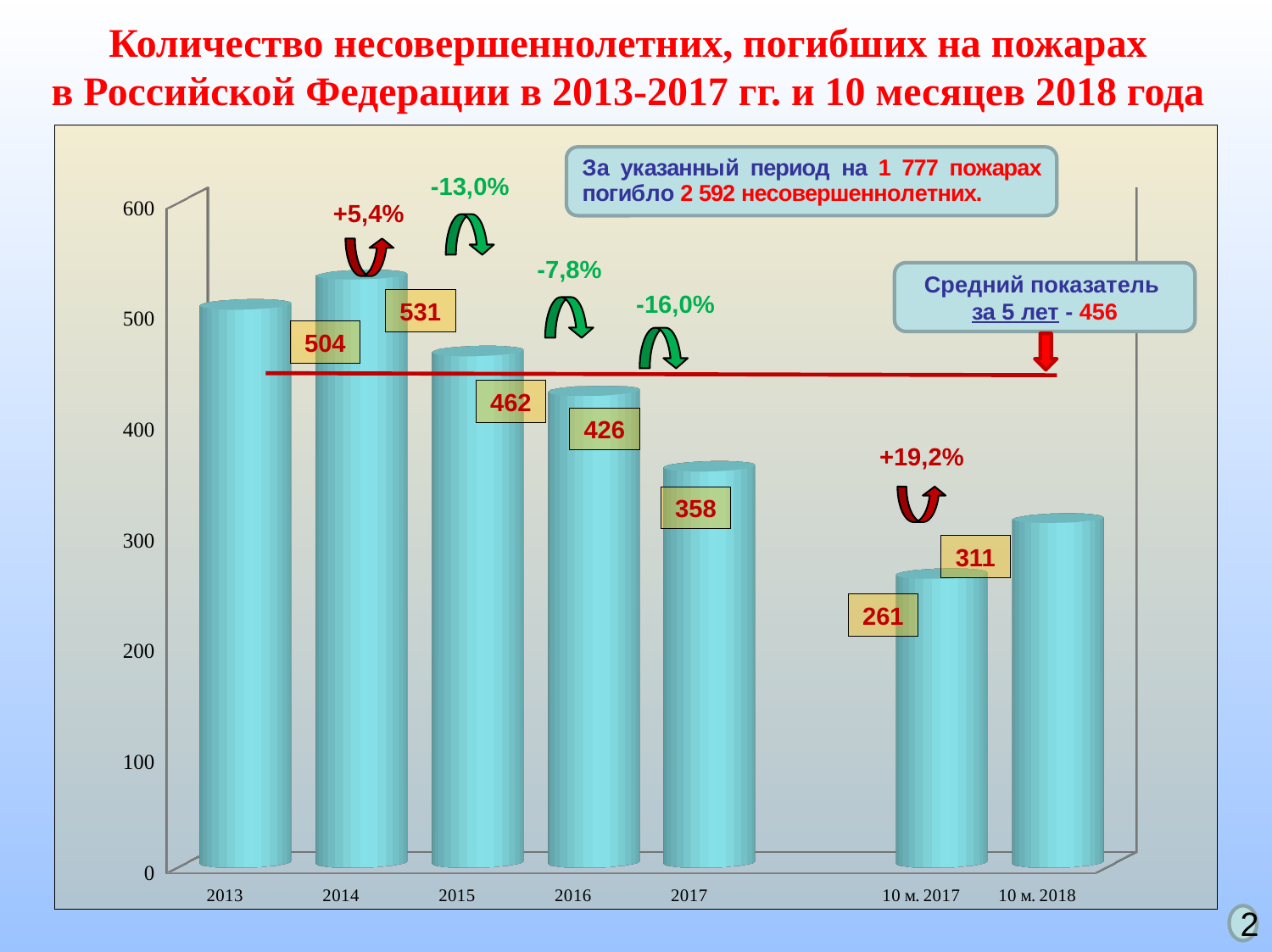
Is the value for 2017 greater or less than 400? less What is the difference between the values for 10 м. 2018 and 10 м. 2017? 50 What is the value for 2013? 504 What is the difference between the values for 2014 and 2015? 69 Which category has the highest value? 2014 How many categories are shown on the x axis? 7 What kind of chart is shown on the slide? bar chart What is the value for 10 м. 2018? 311 Which is larger, the value for 2015 or the value for 2016? 2015 Which category has the lowest value? 10 м. 2017 What is the average value for 5 years shown on the slide? 456 What is the value for 2017? 358